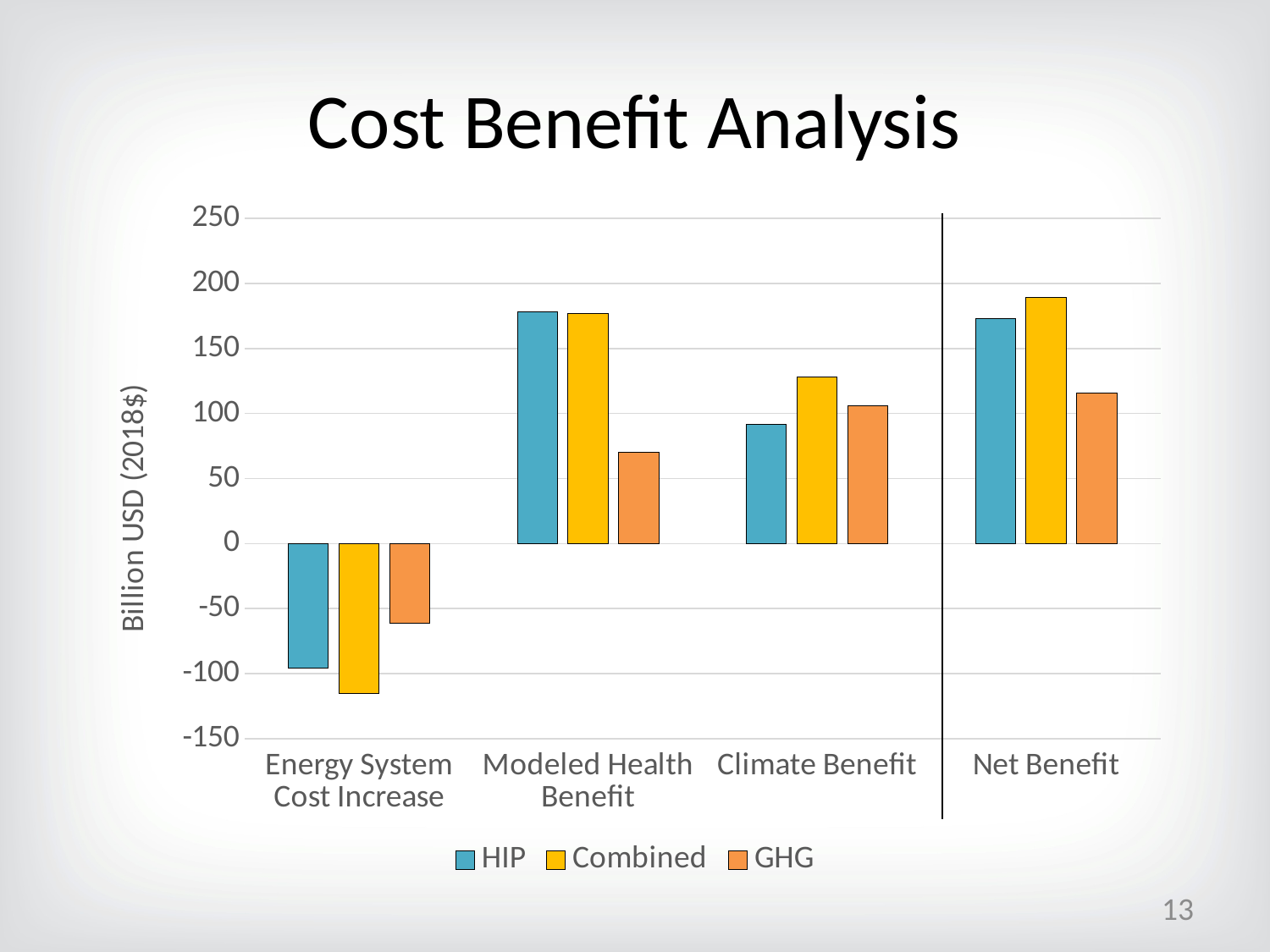
How many series does the legend list? 3 Is the Combined value for Climate Benefit greater or less than 100? greater For Climate Benefit, which is larger: the Combined value or the HIP value? Combined Which series has the highest value for Net Benefit? Combined What kind of chart is shown on the slide? bar chart Is the GHG value for Modeled Health Benefit greater or less than 100? less Is the HIP value for Energy System Cost Increase greater or less than -50? less How many categories are shown on the x axis? 4 Which series has the lowest value for Modeled Health Benefit? GHG What are the entries in the legend? HIP, Combined, GHG Which series has the lowest (most negative) value for Energy System Cost Increase? Combined What is the title of the y axis? Billion USD (2018$)